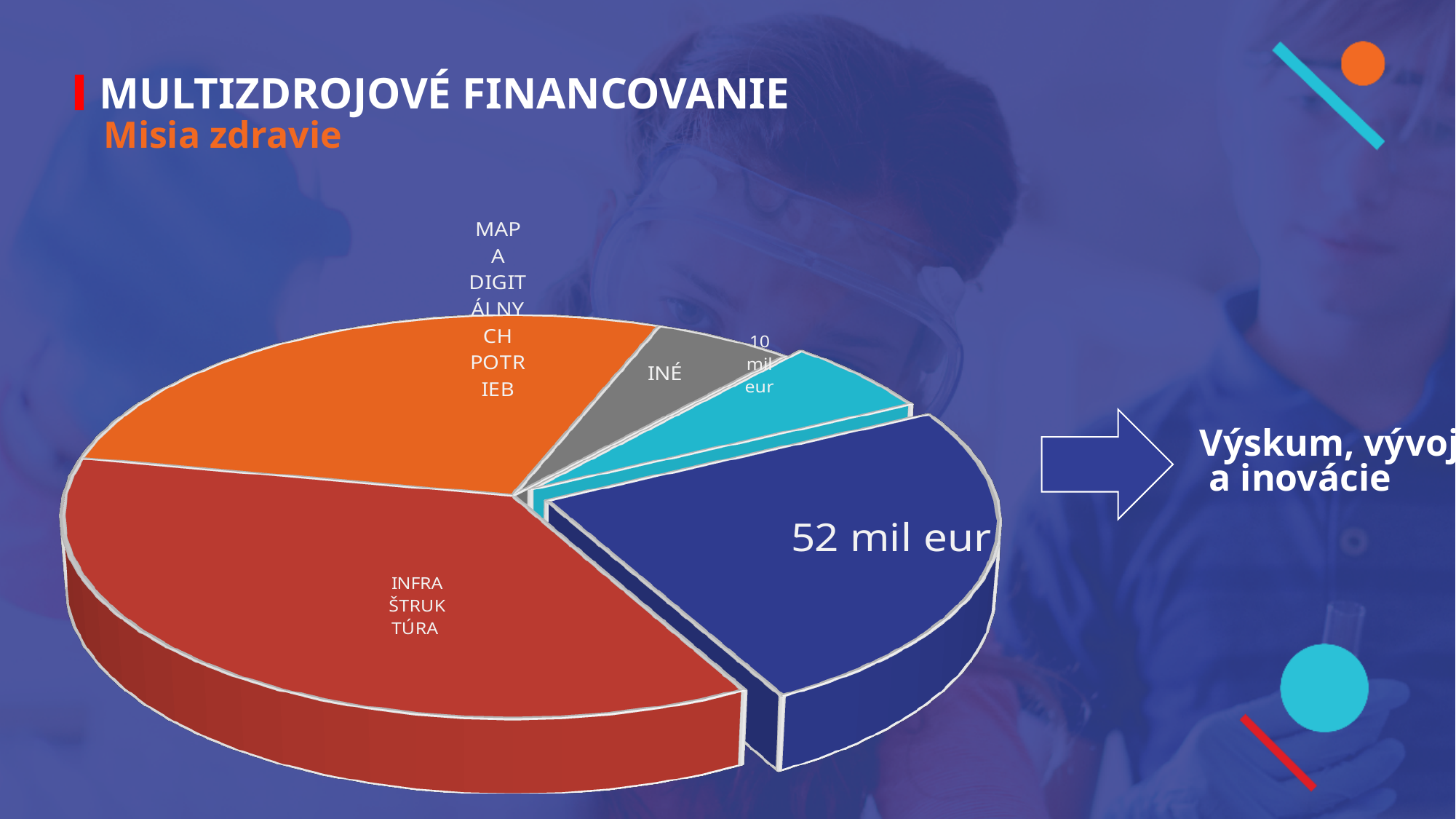
What kind of chart is shown on the slide? pie chart What value is printed on the dark blue slice of the pie chart? 52 mil eur Which slice of the pie chart is the largest? INFRAŠTRUKTÚRA Which slice of the pie chart is pulled out (exploded) from the rest? the 52 mil eur slice How many slices does the pie chart have? 5 What value is printed on the cyan slice of the pie chart? 10 mil eur What colour is the INÉ slice of the pie chart? gray Which is larger, the dark blue slice (52 mil eur) or the cyan slice (10 mil eur)? the dark blue slice (52 mil eur) What is the difference between the 52 mil eur slice and the 10 mil eur slice? 42 mil eur Is the INFRAŠTRUKTÚRA slice larger or smaller than the INÉ slice? larger